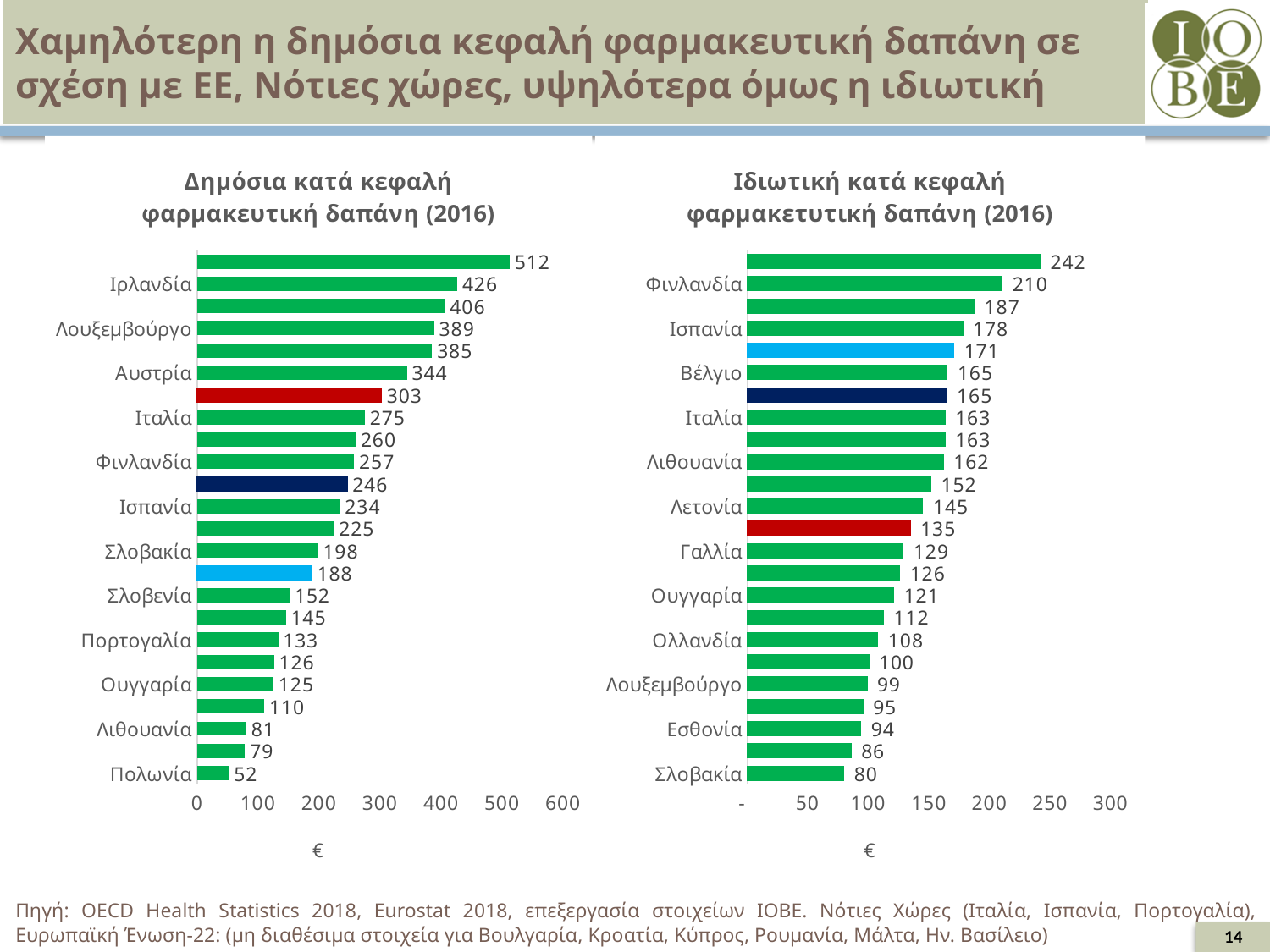
In the left chart (Δημόσια κατά κεφαλή φαρμακευτική δαπάνη), what is the value for Ιρλανδία? 426 In the left chart (Δημόσια κατά κεφαλή φαρμακευτική δαπάνη), what is the difference between Ιρλανδία and Ιταλία? 151 In the right chart (Ιδιωτική κατά κεφαλή φαρμακευτική δαπάνη), what is the value for Φινλανδία? 210 How many bars are plotted in the left chart (Δημόσια κατά κεφαλή φαρμακευτική δαπάνη)? 24 In the right chart (Ιδιωτική κατά κεφαλή φαρμακευτική δαπάνη), is the value for Λετονία greater or less than 100? greater In the right chart (Ιδιωτική κατά κεφαλή φαρμακευτική δαπάνη), what is the difference between Ισπανία and Γαλλία? 49 What type of chart is used on this slide? Bar chart In the left chart (Δημόσια κατά κεφαλή φαρμακευτική δαπάνη), which is larger, Αυστρία or Φινλανδία? Αυστρία In the left chart (Δημόσια κατά κεφαλή φαρμακευτική δαπάνη), which labelled country has the lowest value? Πολωνία In the left chart (Δημόσια κατά κεφαλή φαρμακευτική δαπάνη), what is the value for Πορτογαλία? 133 In the right chart (Ιδιωτική κατά κεφαλή φαρμακευτική δαπάνη), which labelled country has the lowest value? Σλοβακία In the right chart (Ιδιωτική κατά κεφαλή φαρμακευτική δαπάνη), what is the value for Ολλανδία? 108